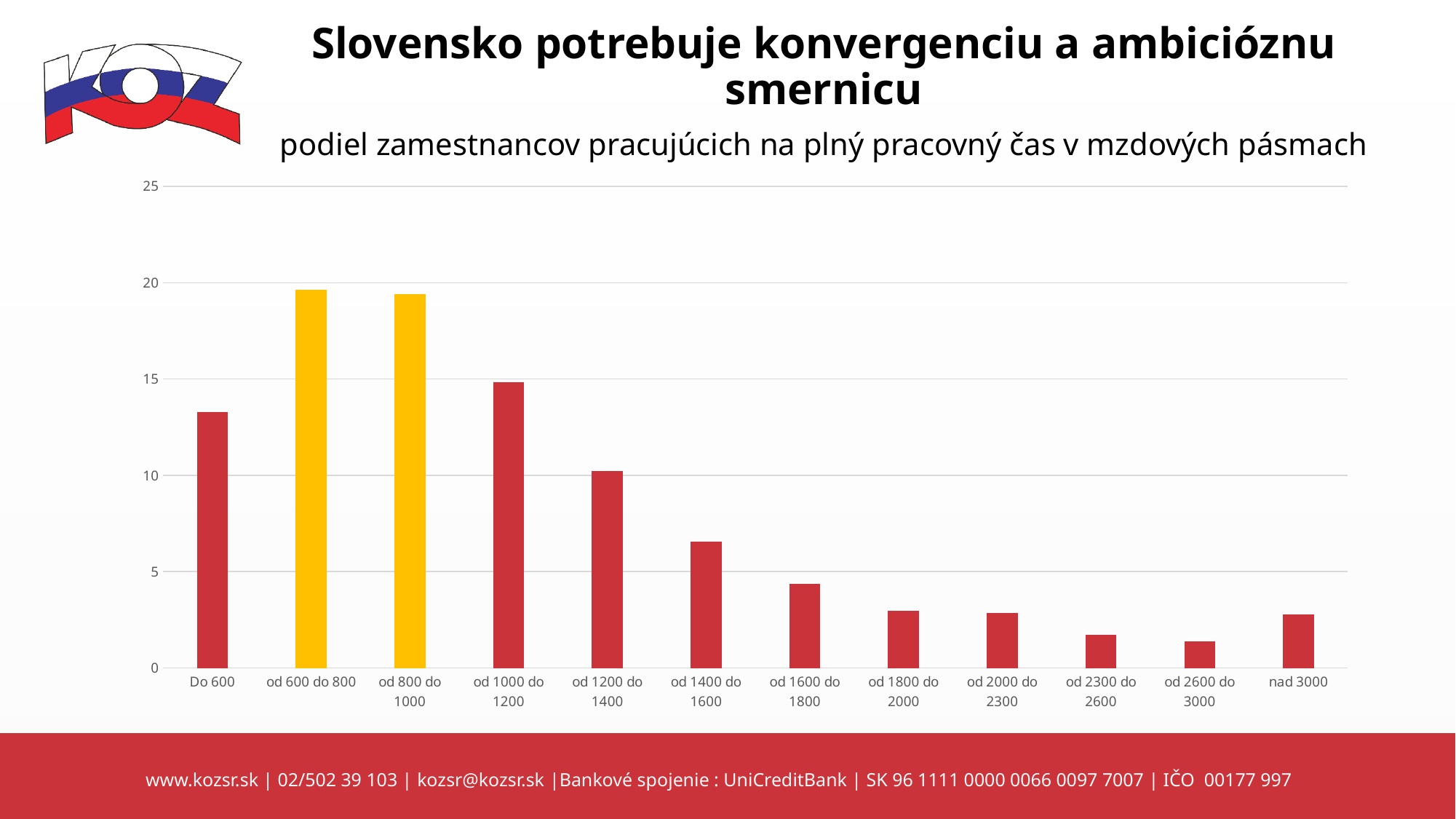
Which two categories are highlighted with yellow bars? od 600 do 800 and od 800 do 1000 Is the value for od 600 do 800 greater or less than 20? less Is the value for od 1600 do 1800 greater or less than 5? less Do the values rise or fall from od 800 do 1000 through od 2600 do 3000? fall Which is larger, the value for Do 600 or the value for od 1000 do 1200? od 1000 do 1200 Is the value for od 1400 do 1600 greater or less than 5? greater Which category has the lowest bar? od 2600 do 3000 What kind of chart is shown on the slide? bar chart How many wage-band categories are plotted on the x axis? 12 Which is larger, the value for od 1400 do 1600 or the value for nad 3000? od 1400 do 1600